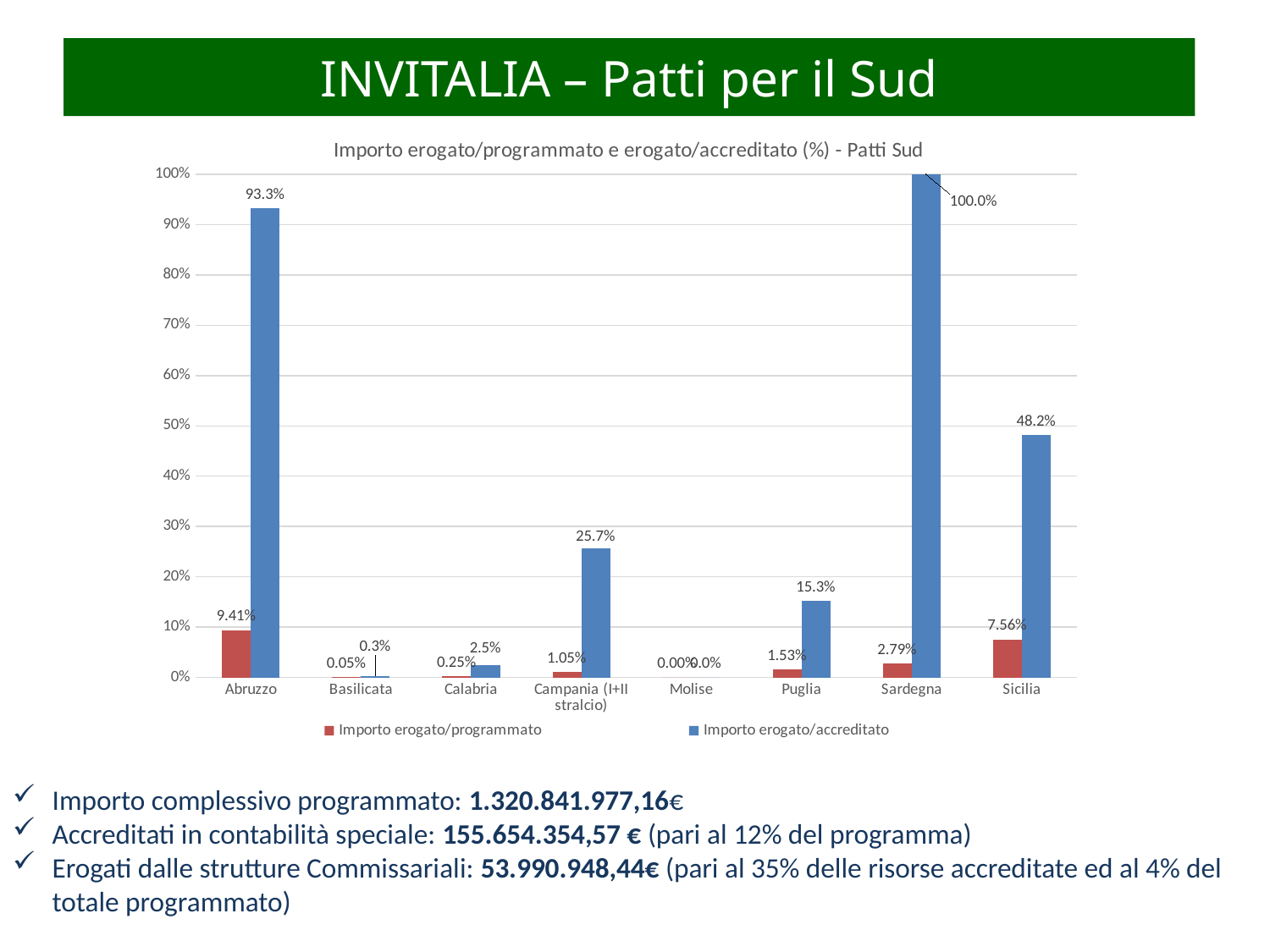
What is the Importo erogato/accreditato value for Campania (I+II stralcio)? 25.7% What is the Importo erogato/accreditato value for Abruzzo? 93.3% How many regions are shown on the x axis? 8 Which is larger, the Importo erogato/accreditato value for Puglia or for Sicilia? Sicilia What is the Importo erogato/programmato value for Puglia? 1.53% Which region has the highest Importo erogato/accreditato value? Sardegna Which region has the lowest Importo erogato/accreditato value? Molise How many series does the legend list? 2 What type of chart is shown on the slide? Bar chart What is the Importo erogato/programmato value for Sicilia? 7.56% Which region has the highest Importo erogato/programmato value? Abruzzo What is the difference between the Importo erogato/accreditato values for Sicilia and Campania (I+II stralcio)? 22.5 percentage points